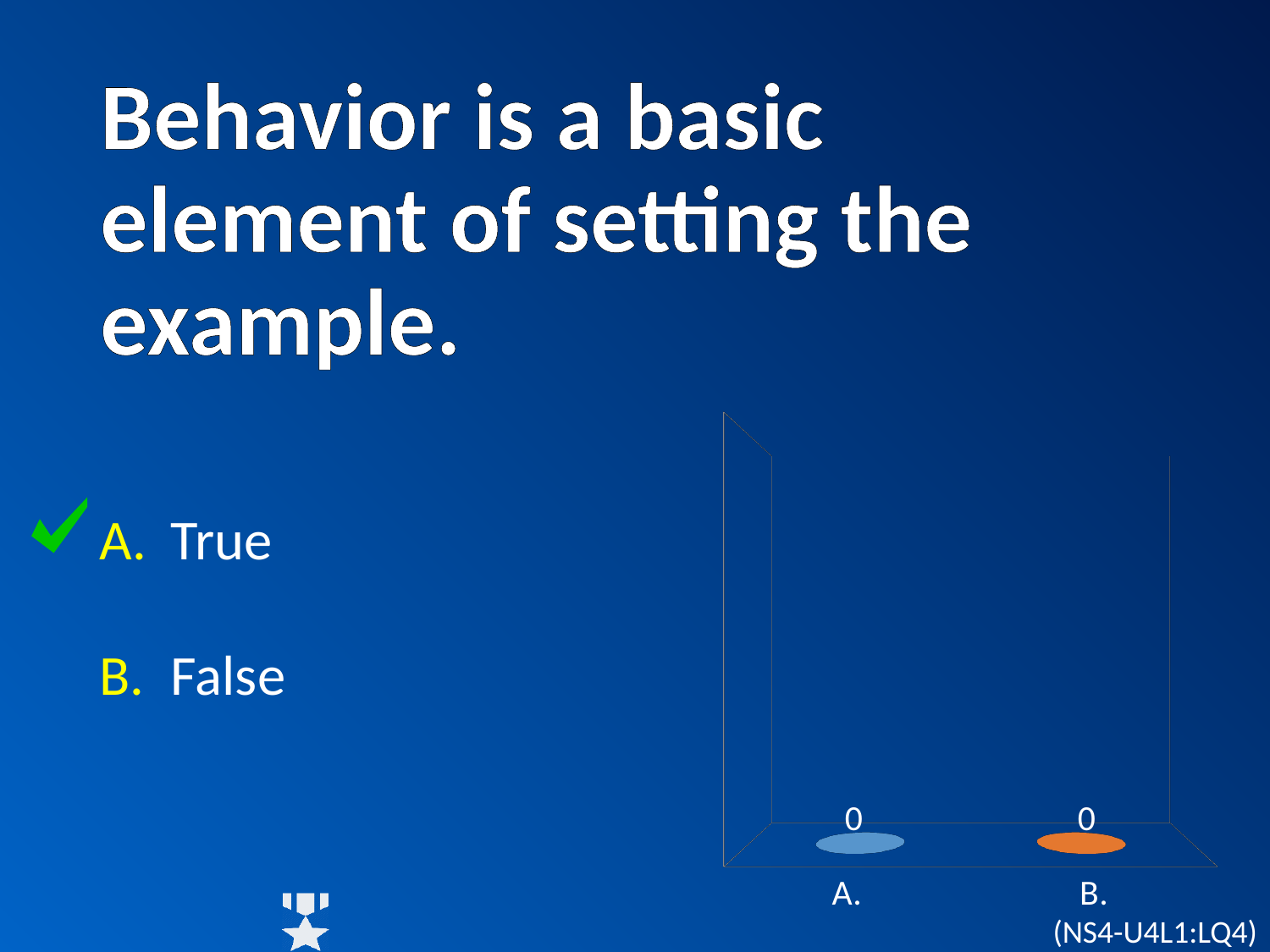
What is the value shown for category A. in the chart? 0 What is the value shown for category B. in the chart? 0 What is the difference between the values for A. and B. in the chart? 0 What kind of chart is shown on the slide? bar chart How many categories are plotted in the chart? 2 What colour is the bar for category B. in the chart? orange What are the category labels on the x axis of the chart? A. and B.